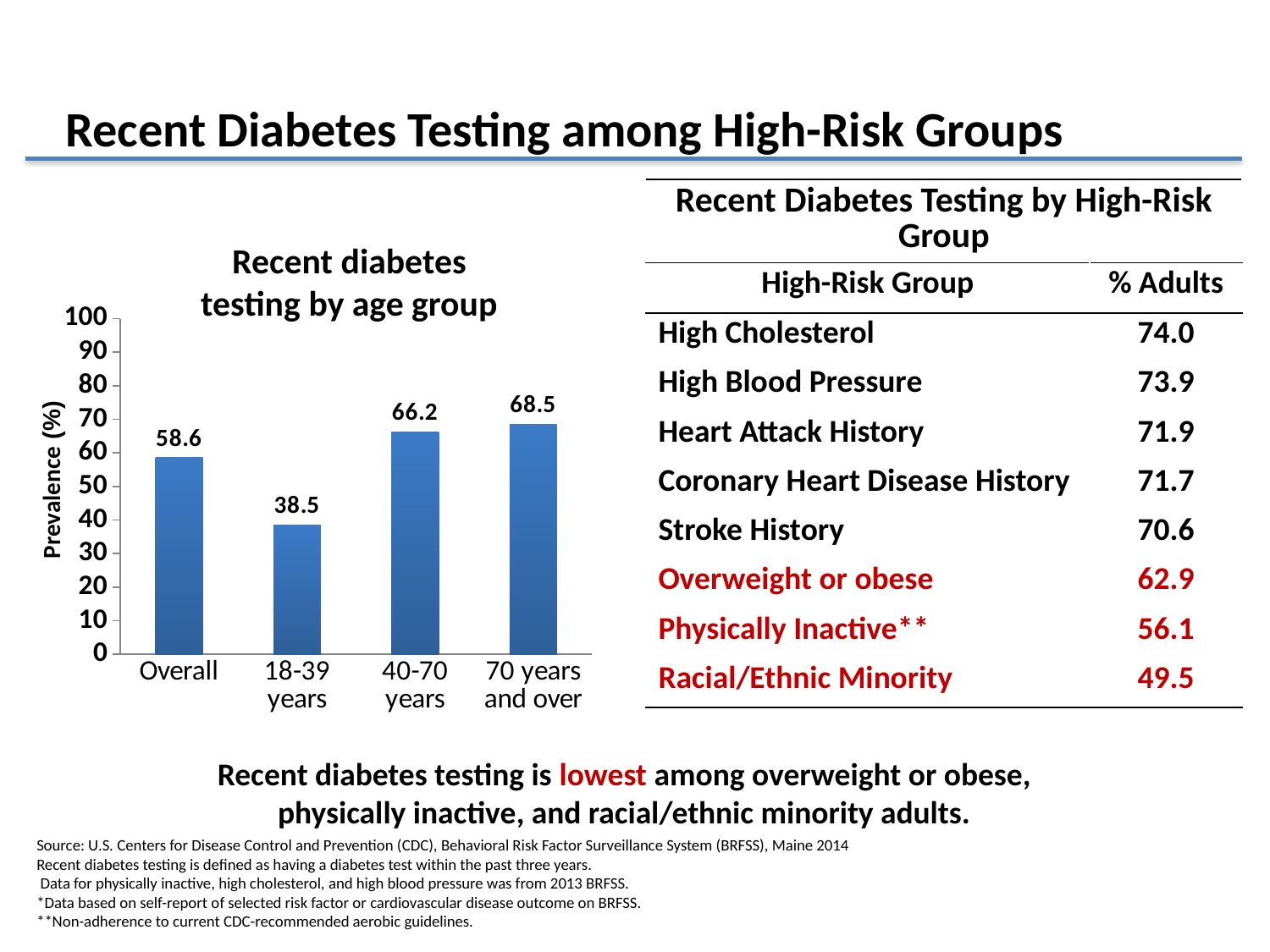
Which category has the lowest value in the chart? 18-39 years What is the difference between the values for 70 years and over and 18-39 years? 30 What is the title of the chart? Recent diabetes testing by age group What is the value for the Overall category in the chart? 58.6 Is the value for 18-39 years greater or less than 40? less Which is larger, the value for 40-70 years or the value for Overall? 40-70 years What is the value for the 18-39 years group in the chart? 38.5 Which age group has the highest value in the chart? 70 years and over What kind of chart is shown on the slide? bar chart How many categories are shown on the x axis of the chart? 4 What is the value for the 70 years and over group in the chart? 68.5 What is the difference between the values for 40-70 years and Overall? 7.6